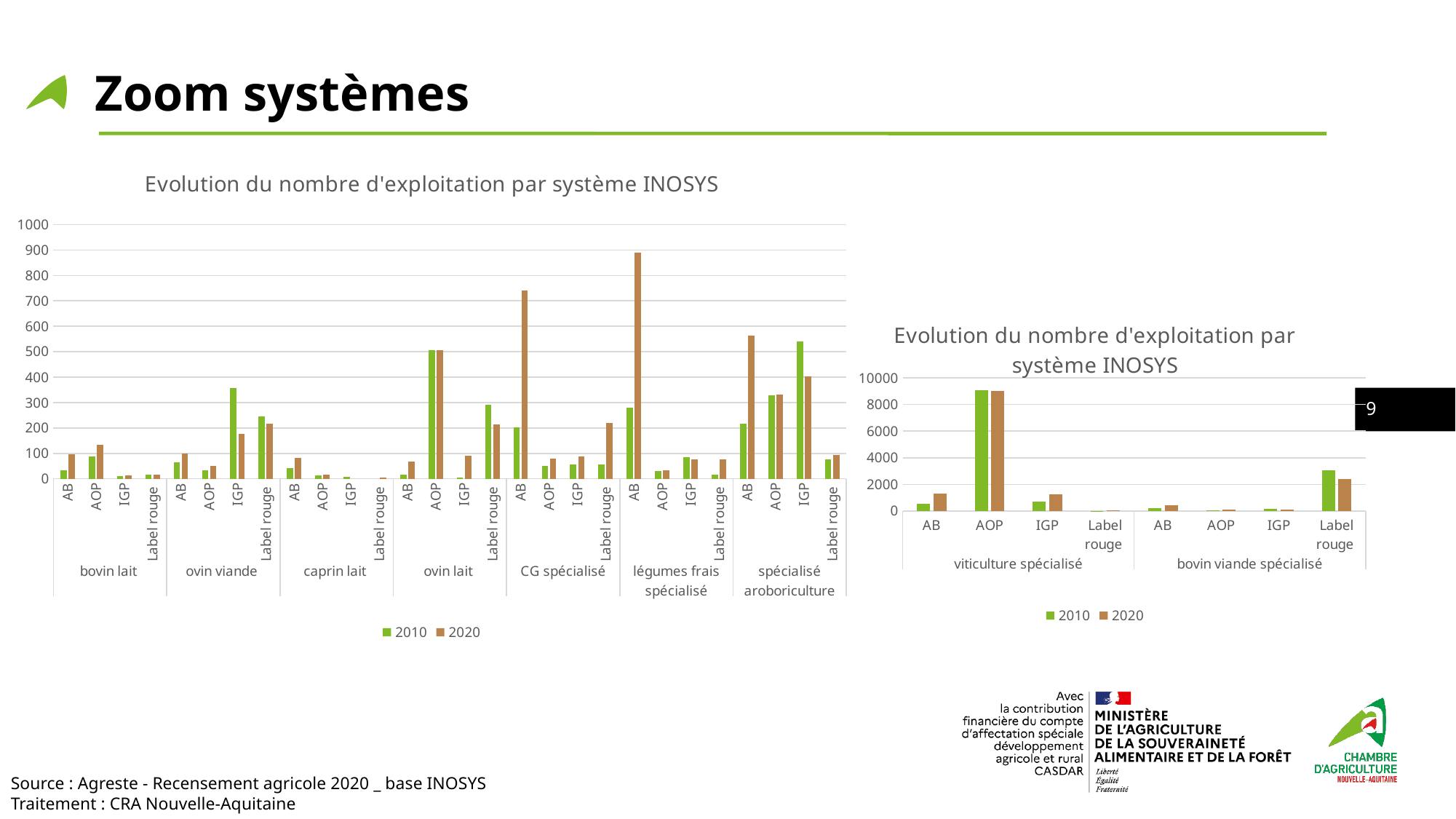
What type of chart is the left chart on the slide? bar chart In the left chart, is the 2020 value for AB in légumes frais spécialisé greater or less than 800? greater In the left chart, which system group contains the tallest bar? légumes frais spécialisé What are the two series shown in the legend of the right chart? 2010 and 2020 In the left chart, for AB in spécialisé aroboriculture, which year has the larger value, 2010 or 2020? 2020 How many series does the legend of the left chart list? 2 In the right chart, which category has the highest values? AOP (viticulture spécialisé) In the right chart, is the 2010 value for Label rouge in bovin viande spécialisé greater or less than 2000? greater In the left chart, is the 2020 value for AB in CG spécialisé greater or less than 700? greater In the left chart, for IGP in ovin viande, which year has the larger value, 2010 or 2020? 2010 How many system groups are shown along the x axis of the right chart? 2